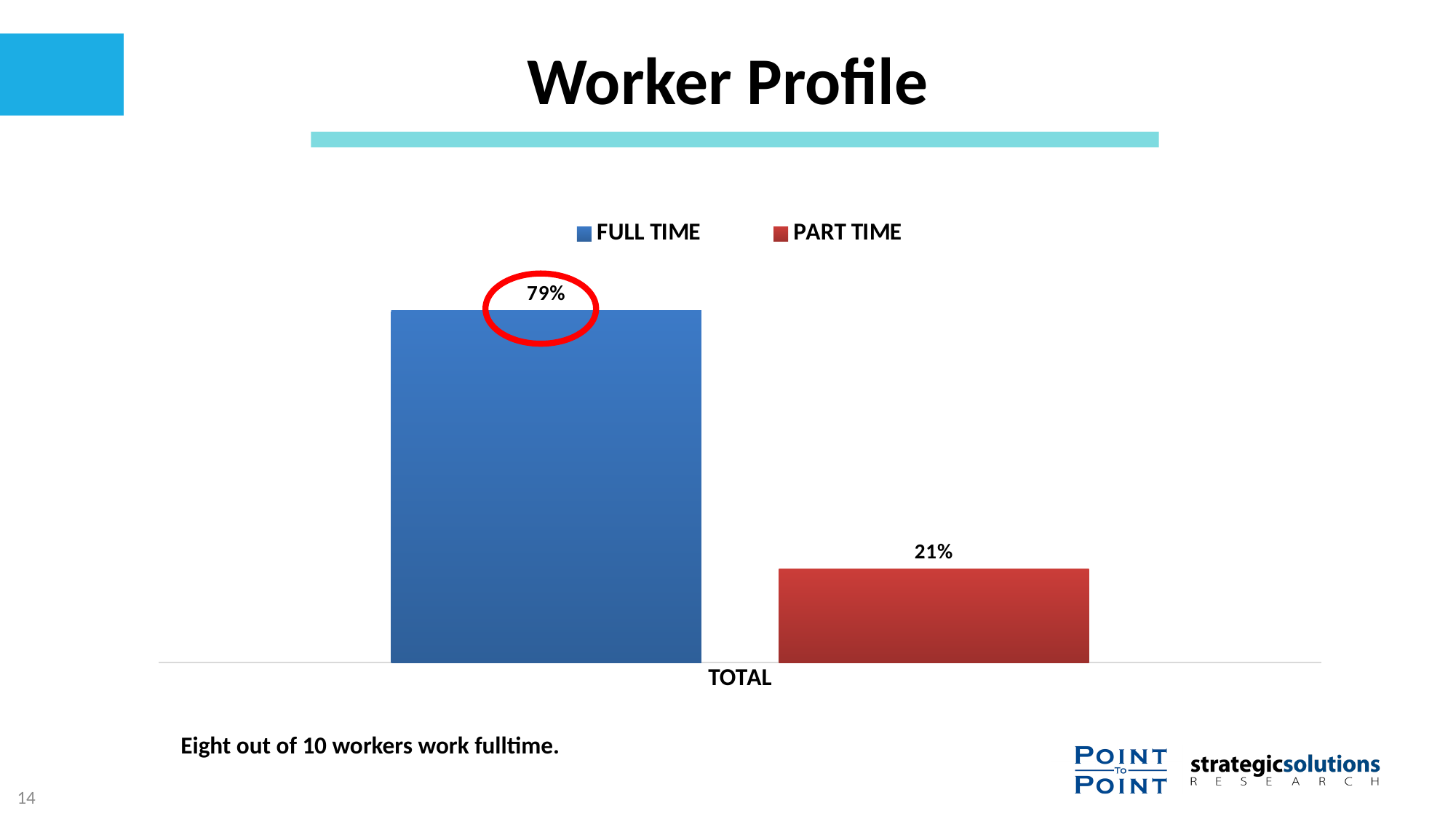
Which data label on the chart is circled in red? 79% What colour is the FULL TIME bar? blue How many series does the legend list? 2 What kind of chart is shown on the slide? bar chart What is the value for PART TIME in the TOTAL category? 21% Is the FULL TIME value larger or smaller than the PART TIME value? larger What is the value for FULL TIME in the TOTAL category? 79% Which series has the lower value, FULL TIME or PART TIME? PART TIME Which series has the higher value, FULL TIME or PART TIME? FULL TIME How many categories are shown on the x axis? 1 What is the difference between the FULL TIME and PART TIME values? 58% What is the sum of the FULL TIME and PART TIME values? 100%